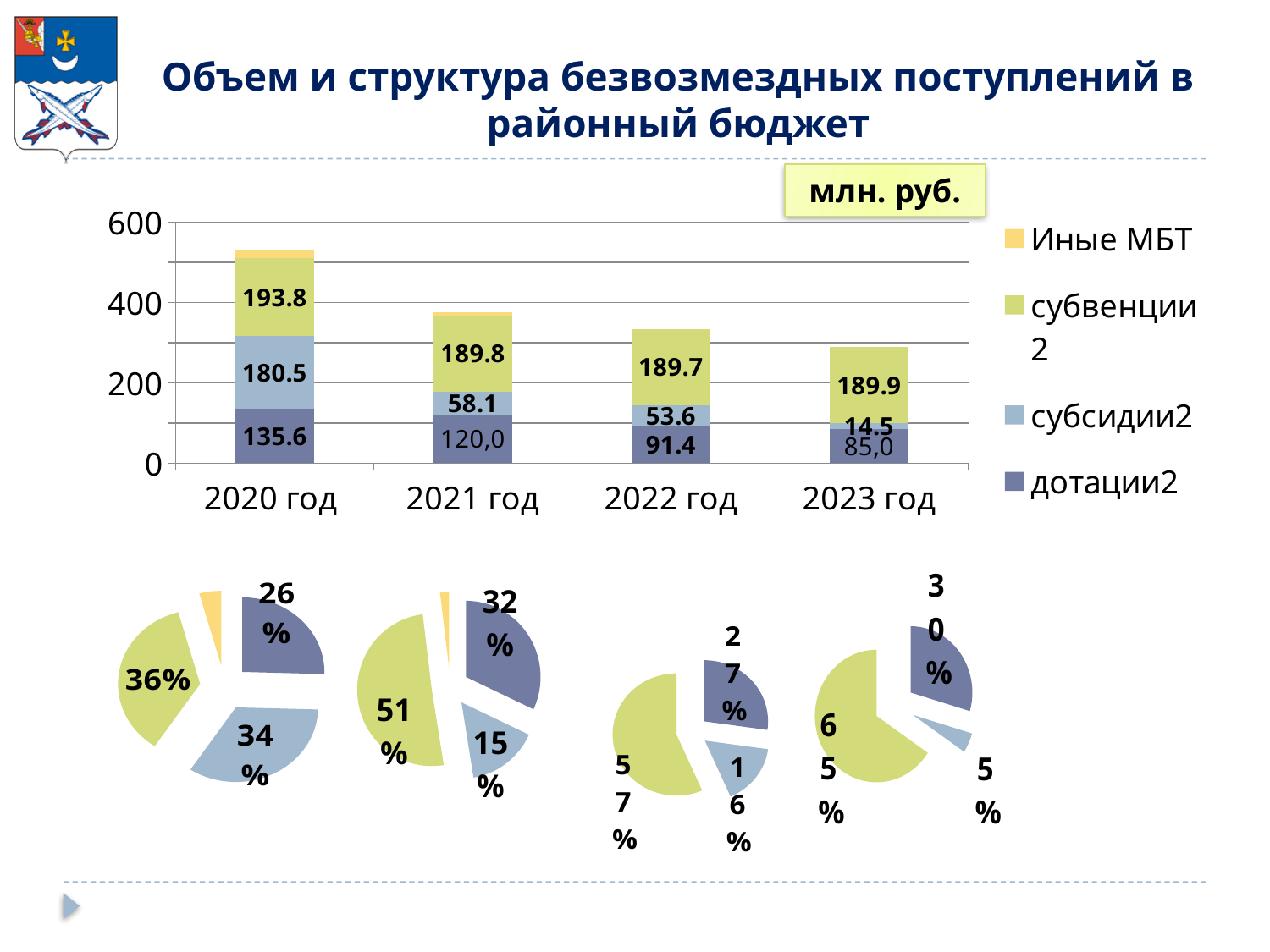
In the stacked bar chart, what is the value of субсидии2 for 2023 год? 14.5 In the rightmost pie chart, what share does the green slice have? 65% In the stacked bar chart, what is the value of субсидии2 for 2021 год? 58.1 In the stacked bar chart, what is the difference between the дотации2 values for 2020 год and 2022 год? 44.2 How many series does the legend of the stacked bar chart list? 4 In the leftmost pie chart, what share does the light blue slice have? 34% In the stacked bar chart, is the total height of the 2023 год bar greater or less than 400? less In the stacked bar chart, which year has the highest value of субсидии2? 2020 год In the stacked bar chart, which year has the lowest value of дотации2? 2023 год In the stacked bar chart, is the субсидии2 value larger for 2021 год or 2022 год? 2021 год In the stacked bar chart, what is the value of субвенции2 for 2020 год? 193.8 In the stacked bar chart, what is the value of дотации2 for 2022 год? 91.4